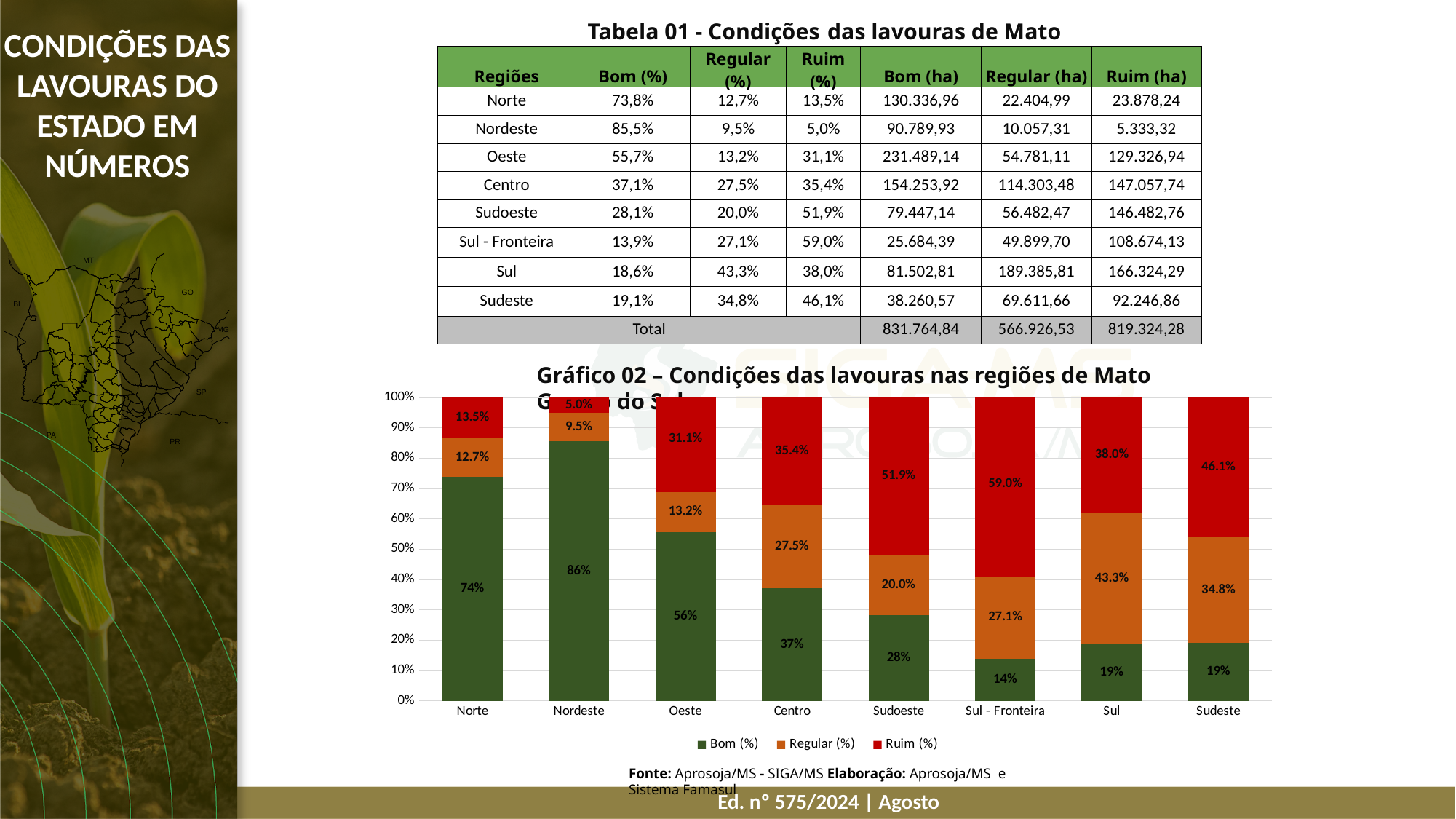
In the stacked bar chart (Gráfico 02), which region has the lowest Ruim (%) value? Nordeste In the stacked bar chart (Gráfico 02), what is the Regular (%) value for Sul? 43.3% What type of chart is Gráfico 02? Stacked bar chart How many regions are shown on the x axis of the stacked bar chart (Gráfico 02)? 8 In the stacked bar chart (Gráfico 02), what is the difference between the Ruim (%) values for Sudoeste and Centro? 16.5% In the stacked bar chart (Gráfico 02), which region has the highest Bom (%) value? Nordeste In the stacked bar chart (Gráfico 02), which region has the highest Ruim (%) value? Sul - Fronteira In the stacked bar chart (Gráfico 02), what is the Ruim (%) value for Sul - Fronteira? 59.0% In the stacked bar chart (Gráfico 02), is the Regular (%) value larger for Sul or for Sudeste? Sul How many series does the legend of the stacked bar chart (Gráfico 02) list? 3 In the stacked bar chart (Gráfico 02), which colour represents the Ruim (%) series? Red In the stacked bar chart (Gráfico 02), what is the Bom (%) value for Norte? 74%